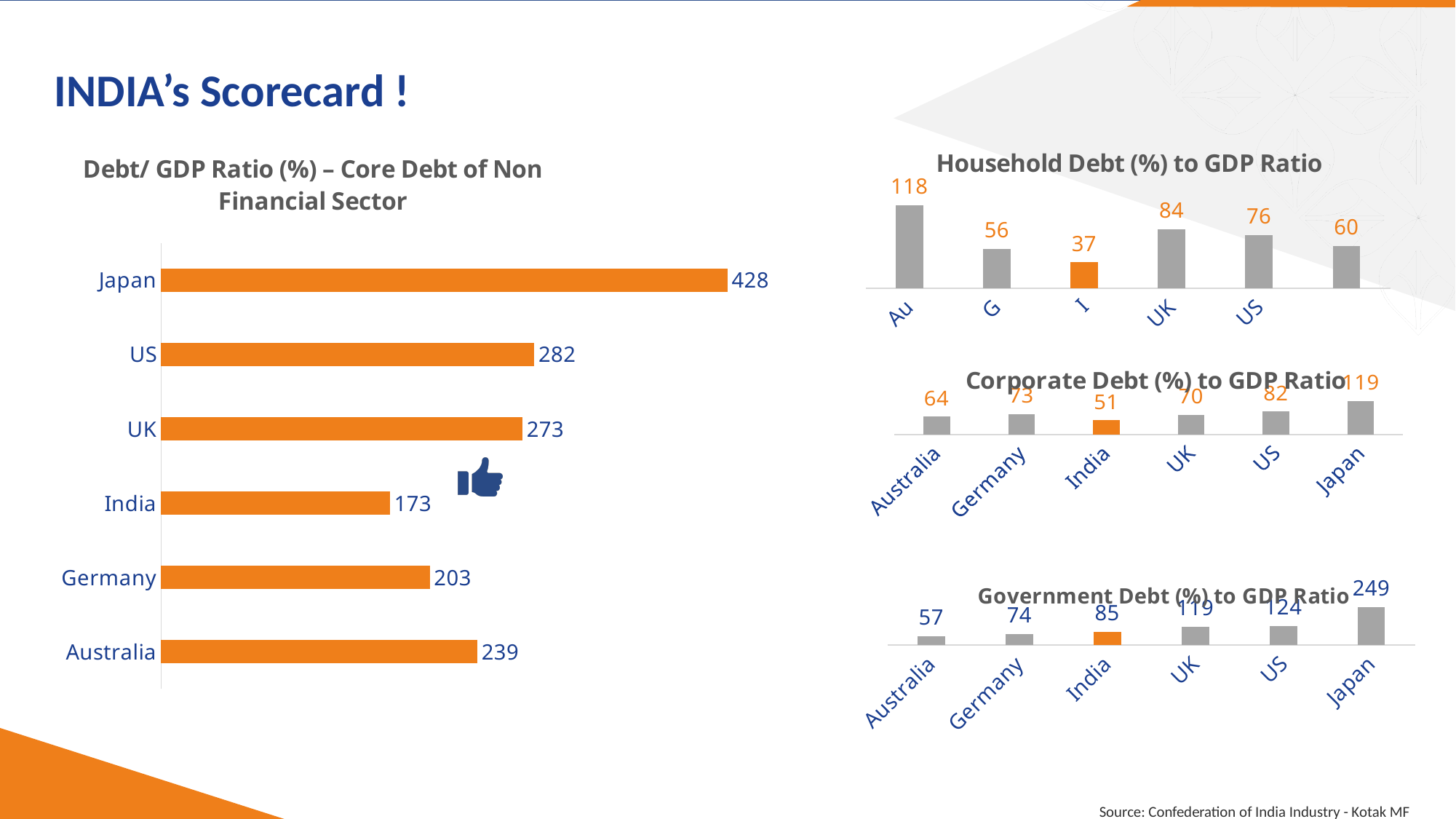
In the 'Household Debt (%) to GDP Ratio' chart, what is the value for the bar labelled 'I'? 37 In the 'Government Debt (%) to GDP Ratio' chart, what is the difference between the values for Japan and US? 125 In the 'Corporate Debt (%) to GDP Ratio' chart, what is the value for Japan? 119 What kind of chart is the 'Debt/ GDP Ratio (%) – Core Debt of Non Financial Sector' chart? Bar chart In the 'Debt/ GDP Ratio (%) – Core Debt of Non Financial Sector' chart, which is larger, Germany or Australia? Australia How many bars are plotted in the 'Household Debt (%) to GDP Ratio' chart? 6 In the 'Debt/ GDP Ratio (%) – Core Debt of Non Financial Sector' chart, what is the value for Japan? 428 In the 'Debt/ GDP Ratio (%) – Core Debt of Non Financial Sector' chart, what is the difference between the values for US and UK? 9 In the 'Household Debt (%) to GDP Ratio' chart, which category has the highest value? Au In the 'Corporate Debt (%) to GDP Ratio' chart, which country has the lowest value? India In the 'Debt/ GDP Ratio (%) – Core Debt of Non Financial Sector' chart, which country has the lowest value? India In the 'Government Debt (%) to GDP Ratio' chart, what is the value for India? 85